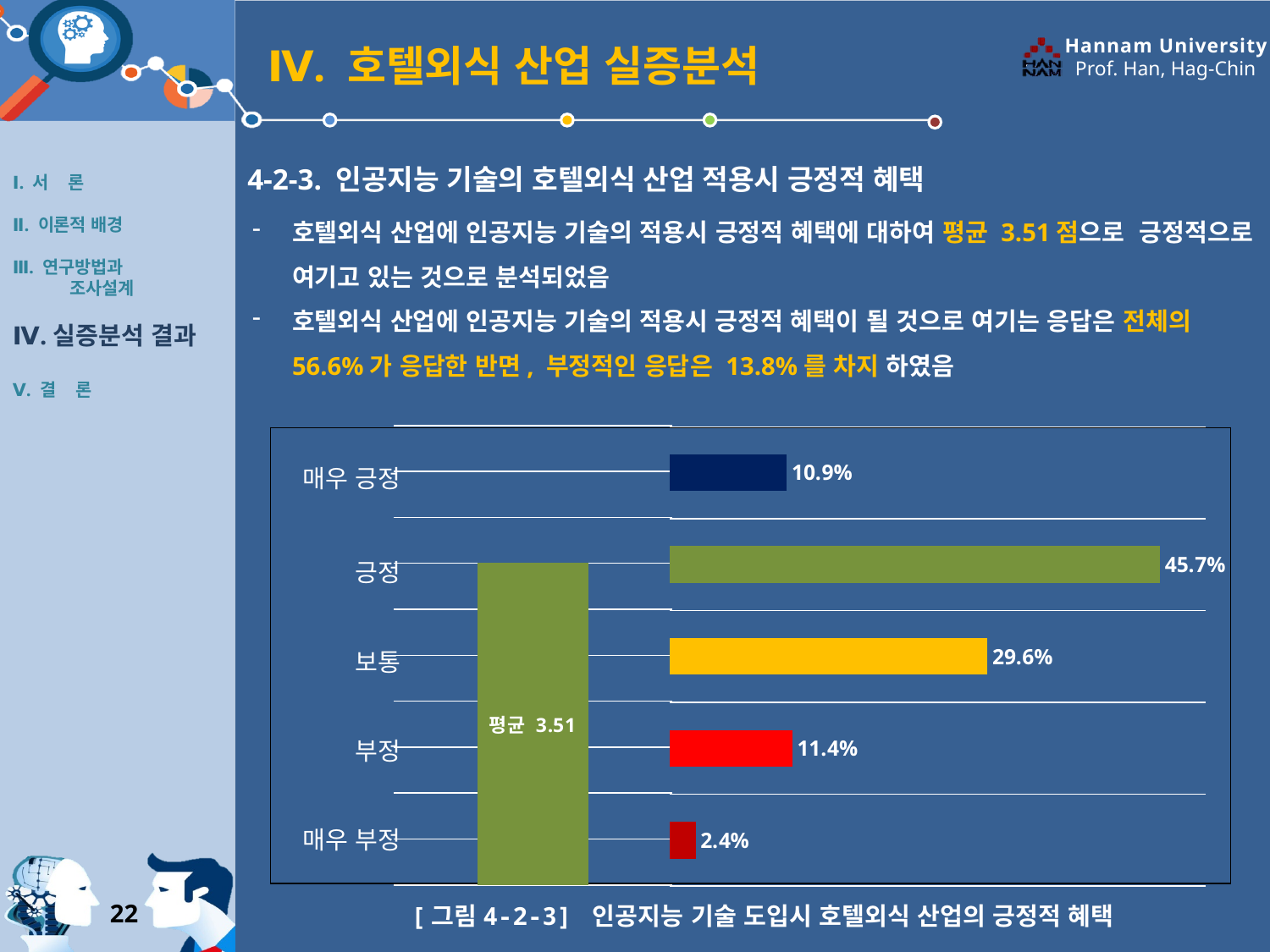
What is the value for 보통 in the chart? 29.6% How many categories are shown in the chart? 5 What average (평균) value is printed inside the chart? 평균 3.51 What kind of chart is shown on the slide? Bar chart What is the difference between the values for 긍정 and 보통? 16.1% Which category has the lowest value in the chart? 매우 부정 What is the sum of the values for 매우 긍정 and 긍정? 56.6% Which is larger, the value for 부정 or the value for 매우 긍정? 부정 What is the value for 매우 부정 in the chart? 2.4% What is the value for 긍정 in the chart? 45.7% What is the value for 매우 긍정 in the chart? 10.9% Which category has the highest value in the chart? 긍정